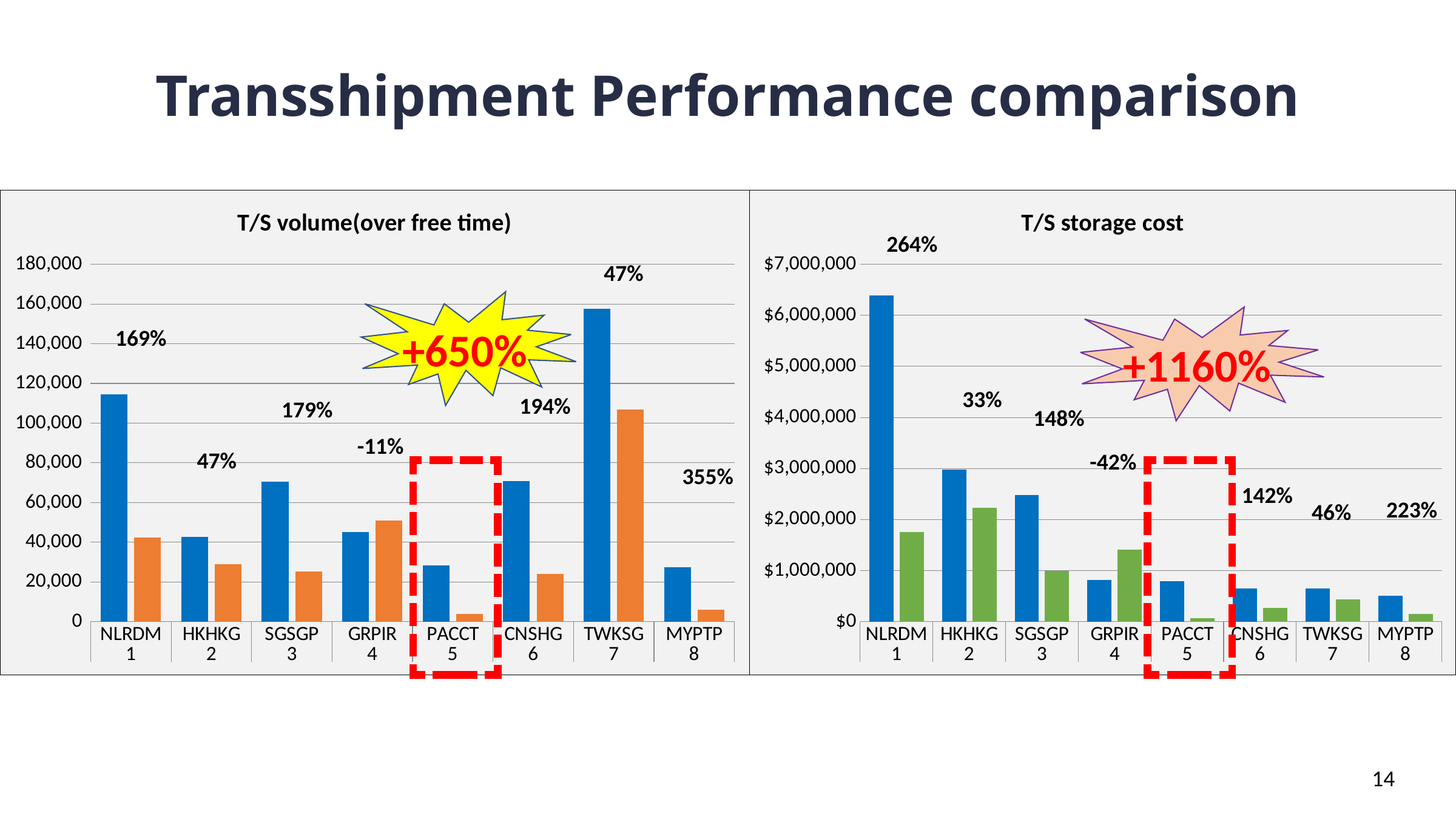
In the "T/S storage cost" chart, is the blue bar for NLRDM greater or less than $6,000,000? greater What value is shown in the yellow starburst callout on the "T/S volume(over free time)" chart? +650% In the "T/S volume(over free time)" chart, is the orange bar for PACCT greater or less than 20,000? less In the "T/S volume(over free time)" chart, which is taller for GRPIR, the blue bar or the orange bar? the orange bar In the "T/S volume(over free time)" chart, is the blue bar for TWKSG greater or less than 140,000? greater What kind of chart is the "T/S volume(over free time)" chart? bar chart What percentage label is printed above PACCT in the "T/S storage cost" chart? +1160% In the "T/S storage cost" chart, which is taller for HKHKG, the blue bar or the green bar? the blue bar What percentage label is printed above PACCT in the "T/S volume(over free time)" chart? +650% In the "T/S volume(over free time)" chart, which category has the tallest blue bar? TWKSG How many categories are shown on the x axis of the "T/S storage cost" chart? 8 In the "T/S storage cost" chart, which category has the tallest blue bar? NLRDM